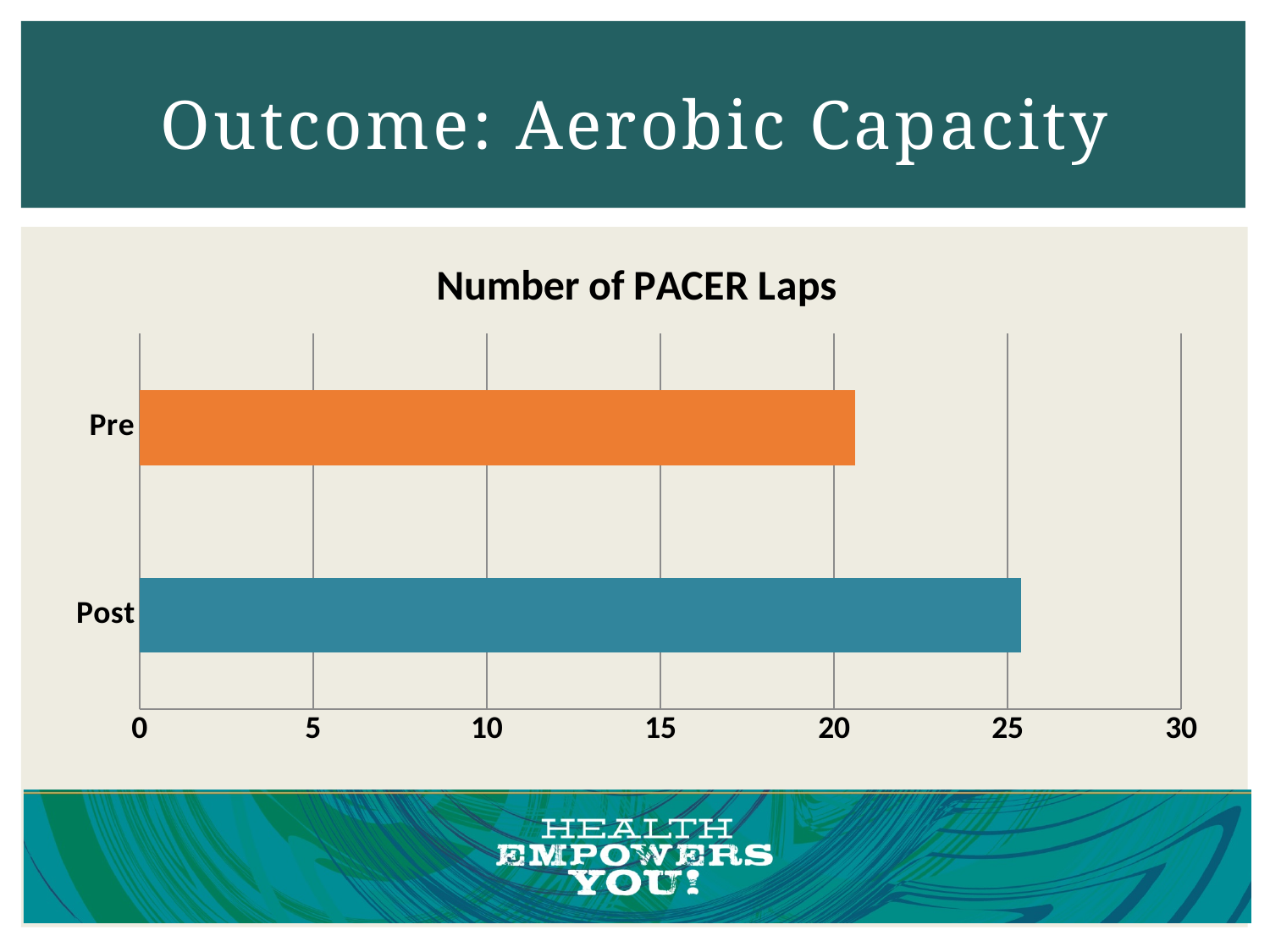
How many categories are shown in the chart? 2 Which category has the lowest number of PACER laps? Pre Is the value for Pre greater or less than 20? greater Which category has the highest number of PACER laps? Post What kind of chart is shown on the slide? bar chart Is the value for Pre greater or less than 25? less Which is larger, the value for Pre or the value for Post? Post Is the value for Post greater or less than 25? greater What is the maximum value shown on the horizontal axis? 30 What is the title of the chart? Number of PACER Laps